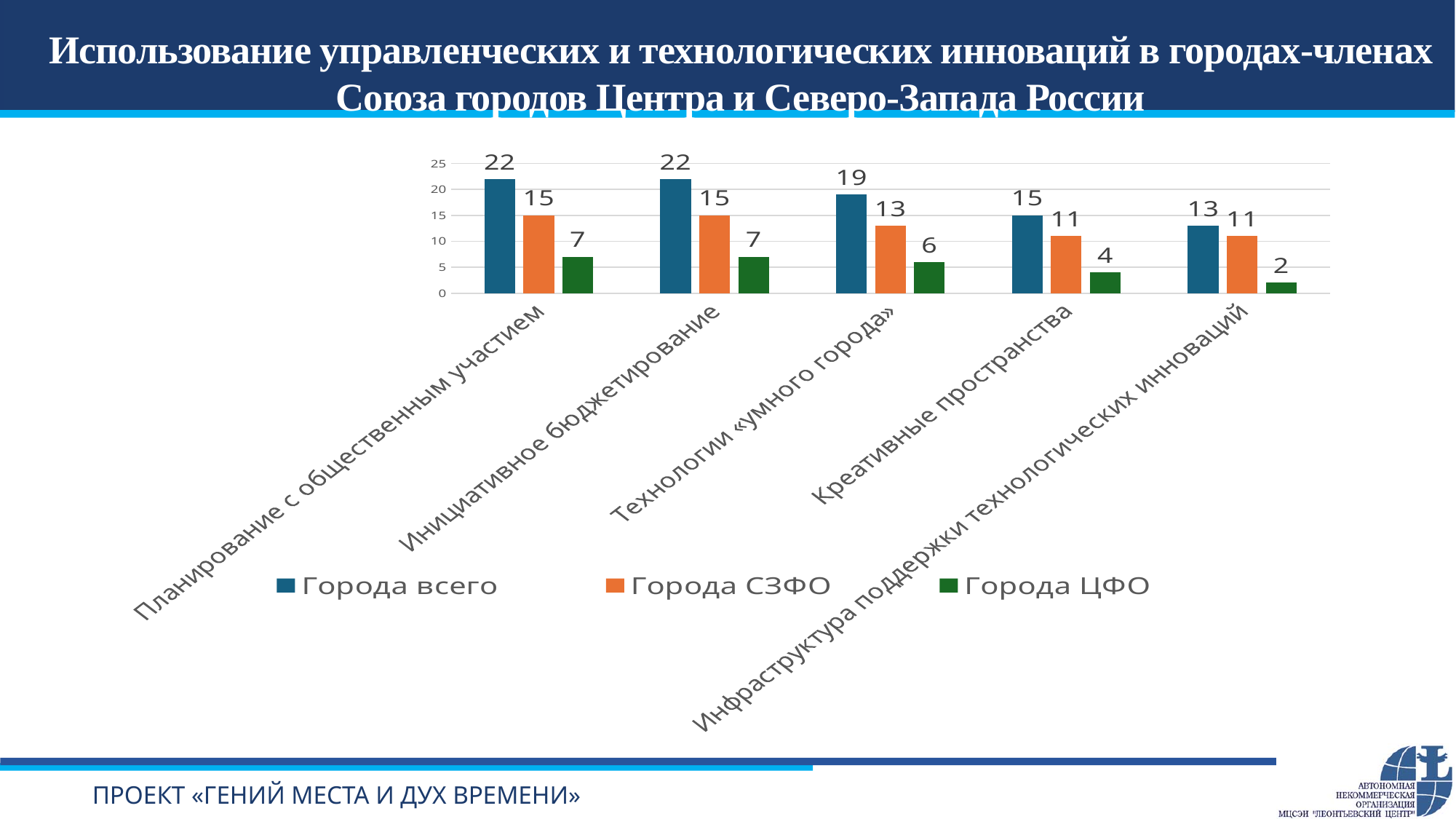
How many categories are shown on the x axis? 5 What is the value for Города СЗФО in the Инфраструктура поддержки технологических инноваций category? 11 Which category has the lowest value for Города ЦФО? Инфраструктура поддержки технологических инноваций Do the values for Города ЦФО rise or fall from left to right along the x axis? Fall What is the difference between Города всего for Планирование с общественным участием and Города всего for Креативные пространства? 7 What kind of chart is shown on the slide? Bar chart How many series does the legend list? 3 What is the value for Города ЦФО in the Креативные пространства category? 4 Which category has the lowest value for Города всего? Инфраструктура поддержки технологических инноваций What is the value for Города всего in the Технологии «умного города» category? 19 Which is larger: Города СЗФО for Технологии «умного города» or Города СЗФО for Креативные пространства? Технологии «умного города» What is the difference between Города СЗФО and Города ЦФО in the Инициативное бюджетирование category? 8